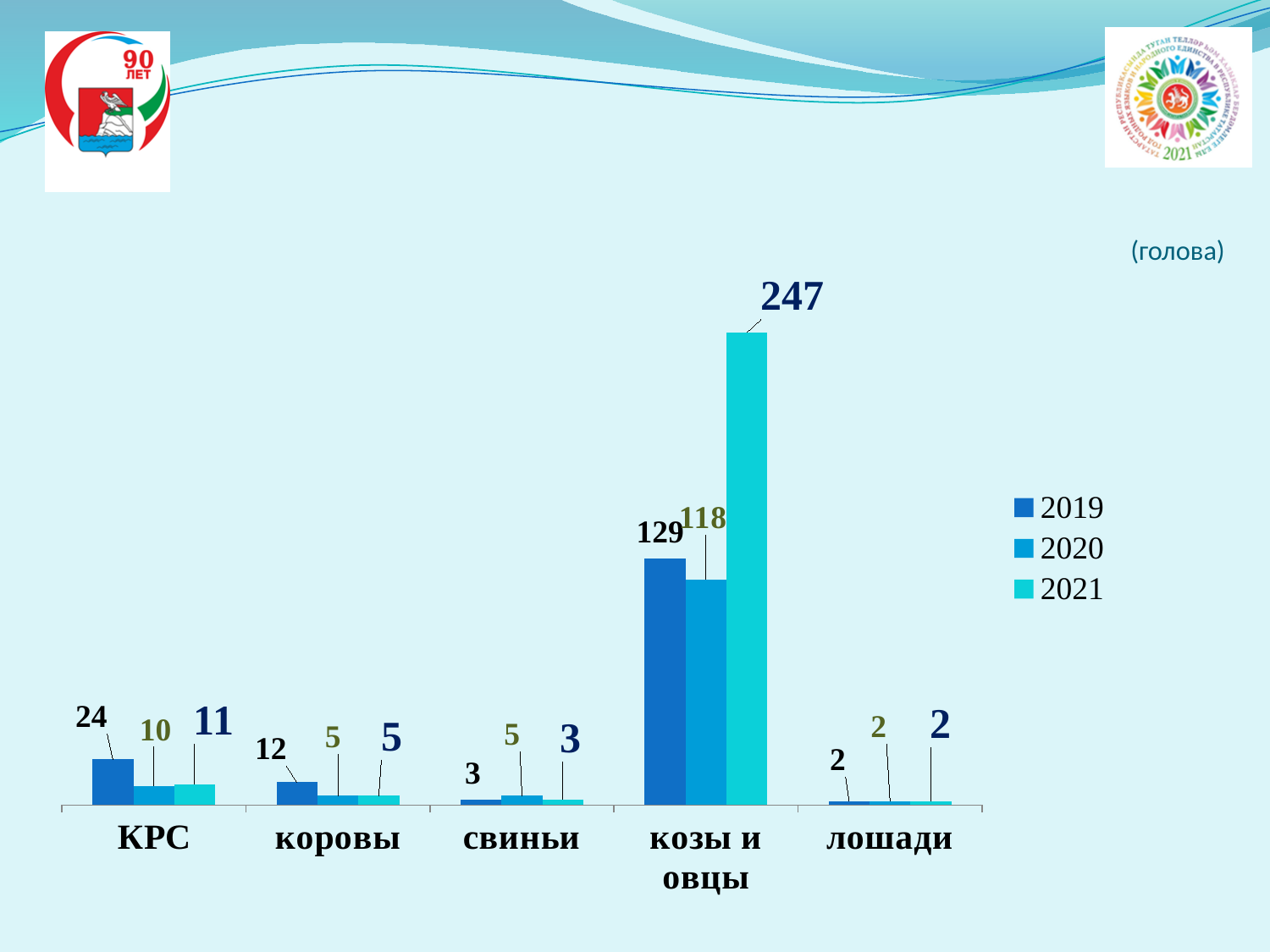
How many categories are shown on the x axis? 5 Which category has the highest value in 2021? козы и овцы Which is larger for козы и овцы: the 2019 value or the 2020 value? 2019 What is the difference between the 2021 and 2019 values for козы и овцы? 118 What kind of chart is shown on the slide? bar chart How many series does the legend list? 3 What is the value for коровы in 2020? 5 What is the value for козы и овцы in 2021? 247 What is the value for свиньи in 2019? 3 Which category has the lowest value in 2019? лошади What is the difference between the 2019 and 2020 values for КРС? 14 What is the value for КРС in 2019? 24